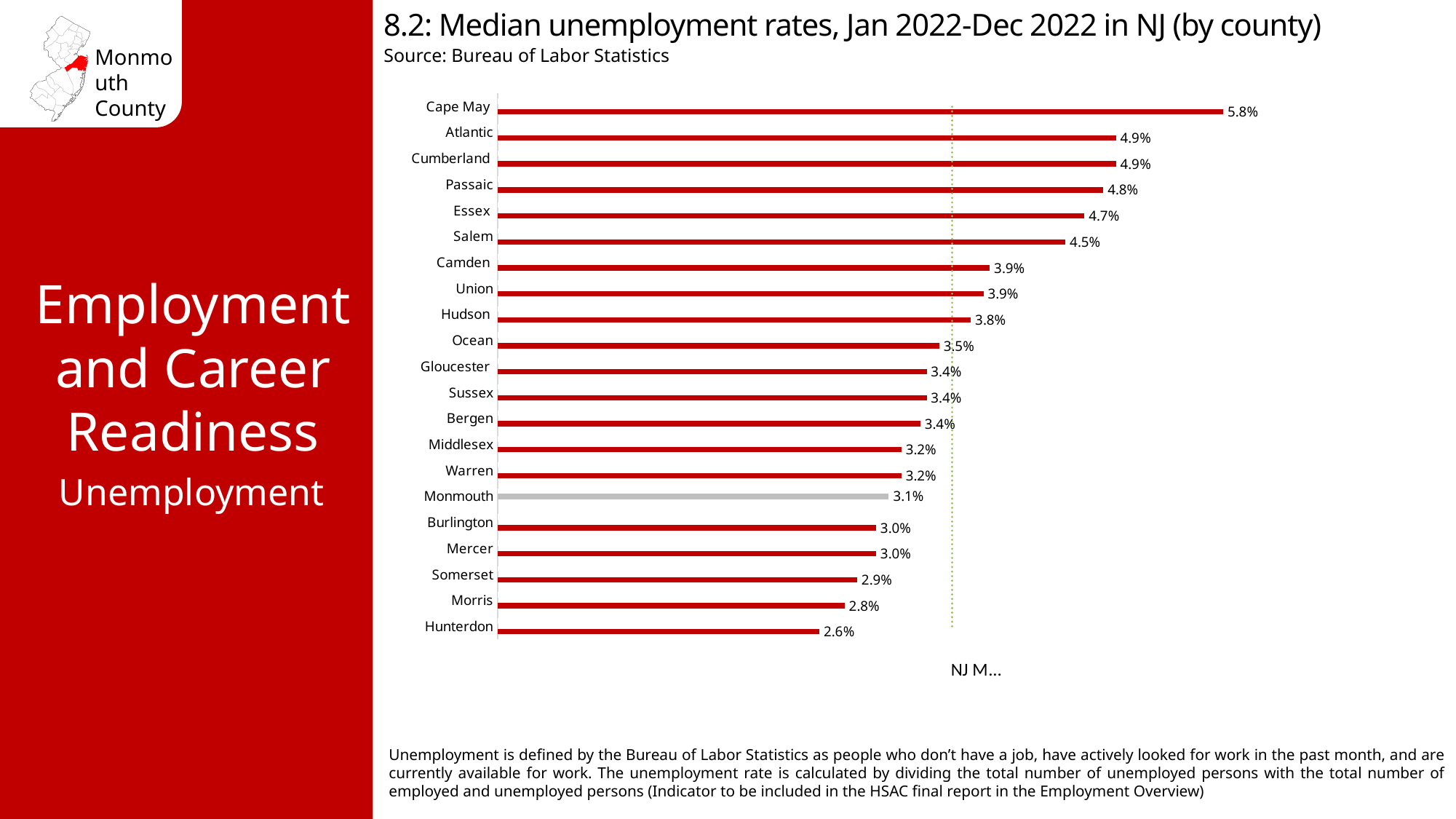
Which county's bar is coloured grey instead of red? Monmouth How many counties are plotted on the chart? 21 Which has a higher median unemployment rate, Passaic or Camden? Passaic What kind of chart is used to show the median unemployment rates? Bar chart Which county has the lowest median unemployment rate on the chart? Hunterdon What is the difference between the median unemployment rates of Cape May and Hunterdon? 3.2 percentage points Do the median unemployment rates rise or fall going from the top of the chart (Cape May) to the bottom (Hunterdon)? Fall What is the difference between the median unemployment rates of Salem and Monmouth? 1.4 percentage points Which county has the highest median unemployment rate on the chart? Cape May What is the median unemployment rate shown for Essex? 4.7% What is the median unemployment rate shown for Cape May? 5.8% What is the median unemployment rate shown for Monmouth County? 3.1%